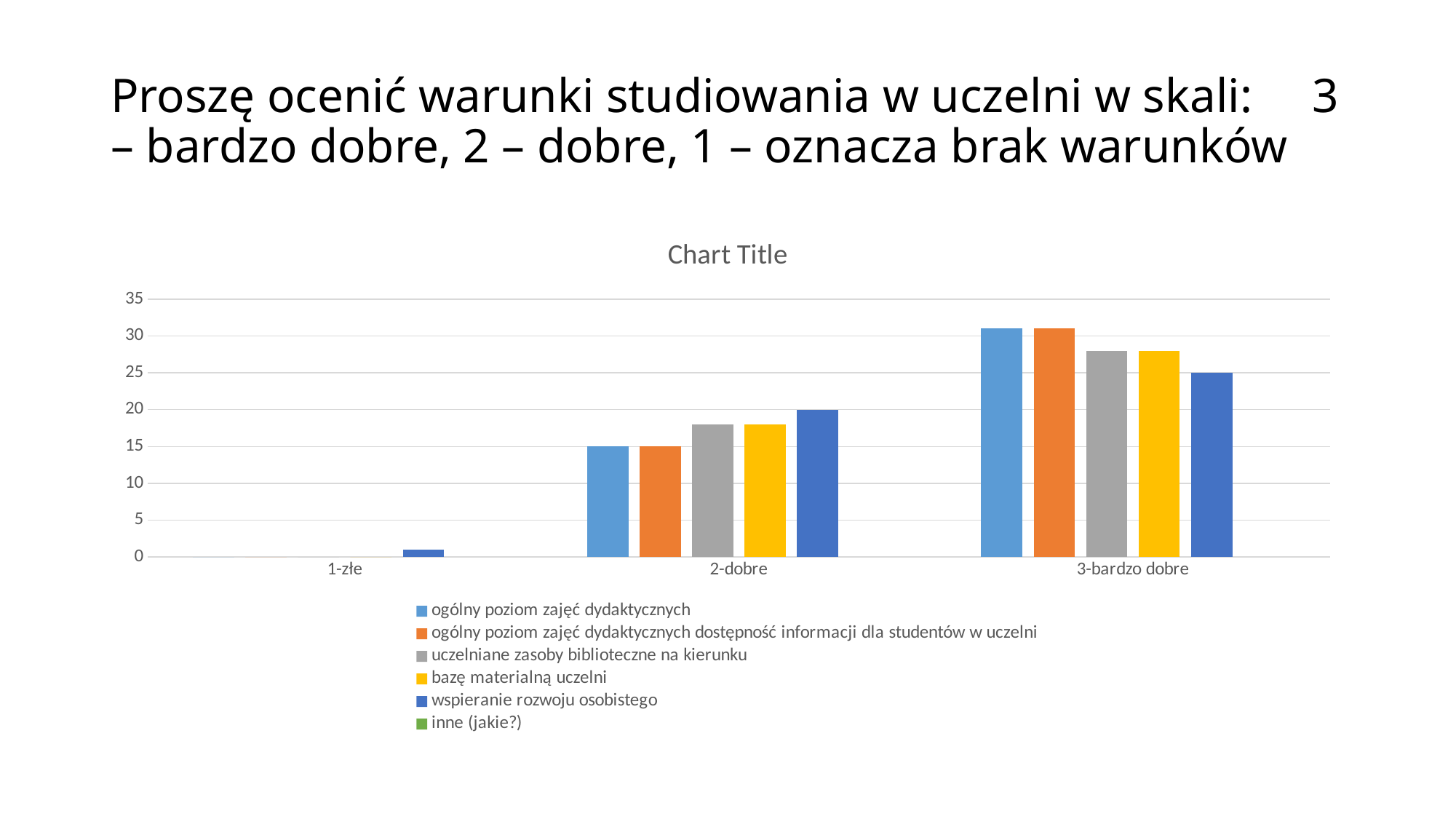
What is the title shown above the chart? Chart Title Is the value for 'bazę materialną uczelni' in '3-bardzo dobre' greater or less than 25? greater What kind of chart is shown on the slide? bar chart In the '2-dobre' category, which is larger: 'wspieranie rozwoju osobistego' or 'ogólny poziom zajęć dydaktycznych'? wspieranie rozwoju osobistego What is the value for 'wspieranie rozwoju osobistego' in the '3-bardzo dobre' category? 25 What is the value for 'ogólny poziom zajęć dydaktycznych' in the '2-dobre' category? 15 In the '2-dobre' category, what is the difference between 'wspieranie rozwoju osobistego' and 'ogólny poziom zajęć dydaktycznych'? 5 How many series does the legend list? 6 Is the value for 'wspieranie rozwoju osobistego' in '1-złe' greater or less than 5? less Is the value for 'ogólny poziom zajęć dydaktycznych' in '3-bardzo dobre' greater or less than 30? greater How many categories are shown on the x axis? 3 What is the value for 'wspieranie rozwoju osobistego' in the '2-dobre' category? 20